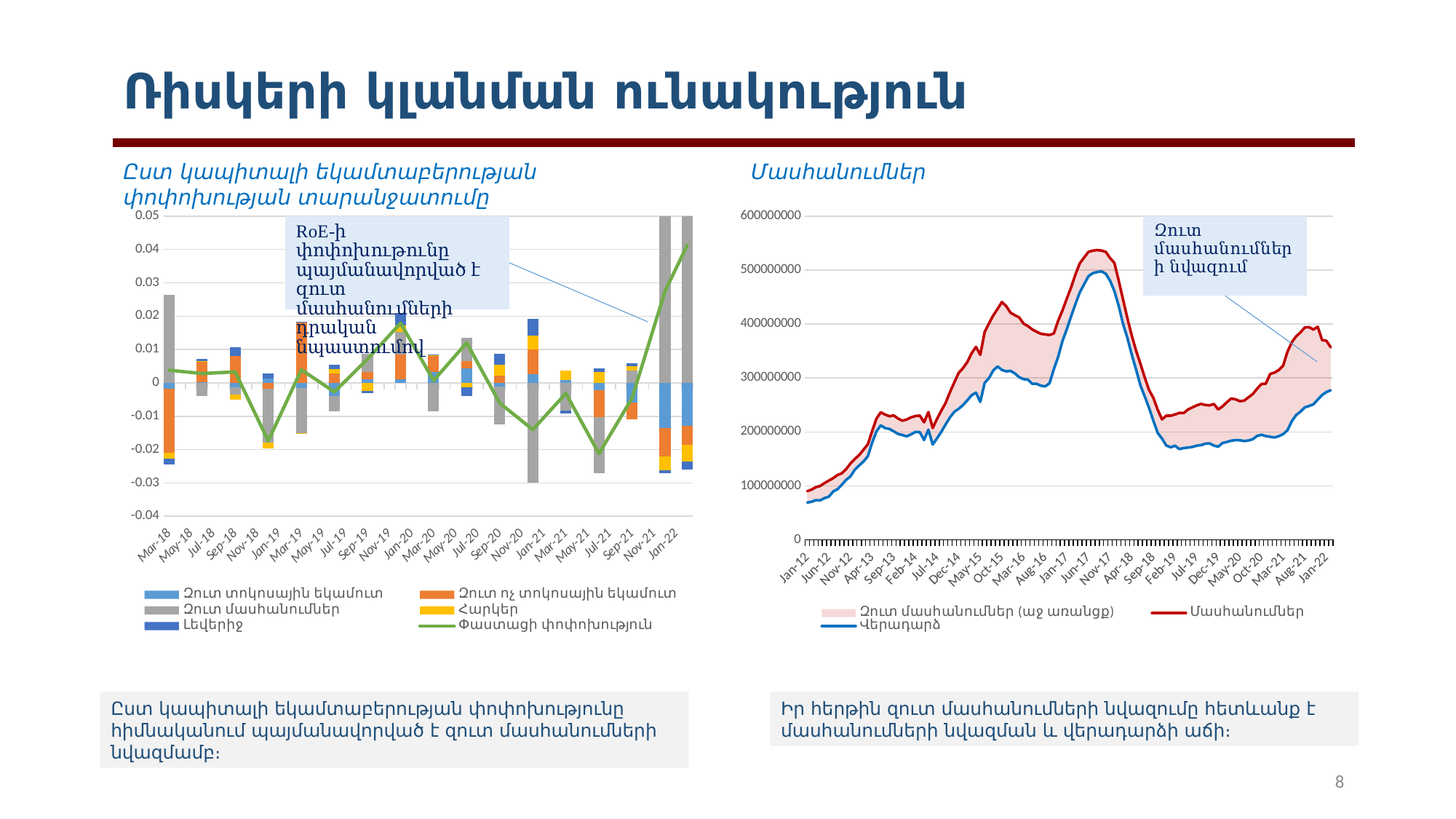
In the right-hand chart, which legend entry does the red line represent? Մասհանումներ What kind of chart is the right-hand chart titled "Մասհանումներ"? combination area and line chart In the right-hand chart, is the value of the red "Մասհանումներ" line at Jan-12 greater or less than 100000000? less In the left-hand chart, how many dates are labelled along the x axis? 24 In the right-hand chart, do the values of the red "Մասհանումներ" line rise or fall from Jan-12 to Jun-17? rise In the right-hand chart, which line is higher around Jun-17: the red "Մասհանումներ" line or the blue "Վերադարձ" line? Մասհանումներ In the left-hand chart, how many series does the legend list? 6 In the right-hand chart, is the value of the red "Մասհանումներ" line at Jan-22 greater or less than 300000000? greater In the left-hand chart, is the grey "Զուտ մասհանումներ" bar at Mar-18 greater or less than 0.02? greater In the right-hand chart titled "Մասհանումներ", how many entries does the legend list? 3